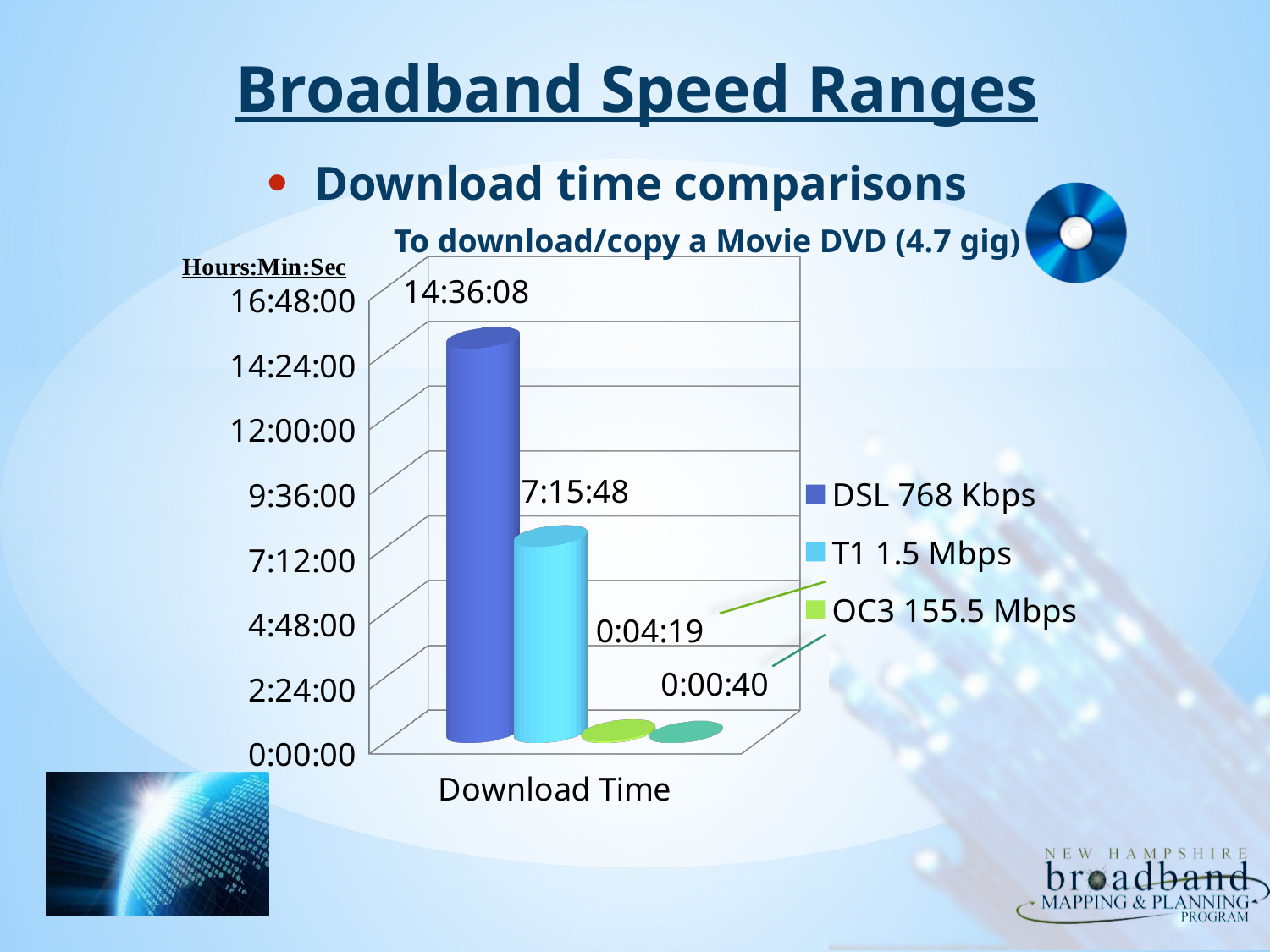
What is the title of the chart? To download/copy a Movie DVD (4.7 gig) What is the difference in download time between DSL 768 Kbps and T1 1.5 Mbps? 7:20:20 Which takes longer to download the DVD, DSL 768 Kbps or T1 1.5 Mbps? DSL 768 Kbps What is the download time for OC3 155.5 Mbps? 0:04:19 What is the download time for DSL 768 Kbps? 14:36:08 How many bars are plotted in the chart? 4 What is the download time for T1 1.5 Mbps? 7:15:48 Which connection type has the longest download time? DSL 768 Kbps Is the download time for T1 1.5 Mbps greater or less than 9:36:00? less What type of chart is shown on the slide? bar chart Which takes less time to download the DVD, T1 1.5 Mbps or OC3 155.5 Mbps? OC3 155.5 Mbps How many entries does the chart's legend list? 3